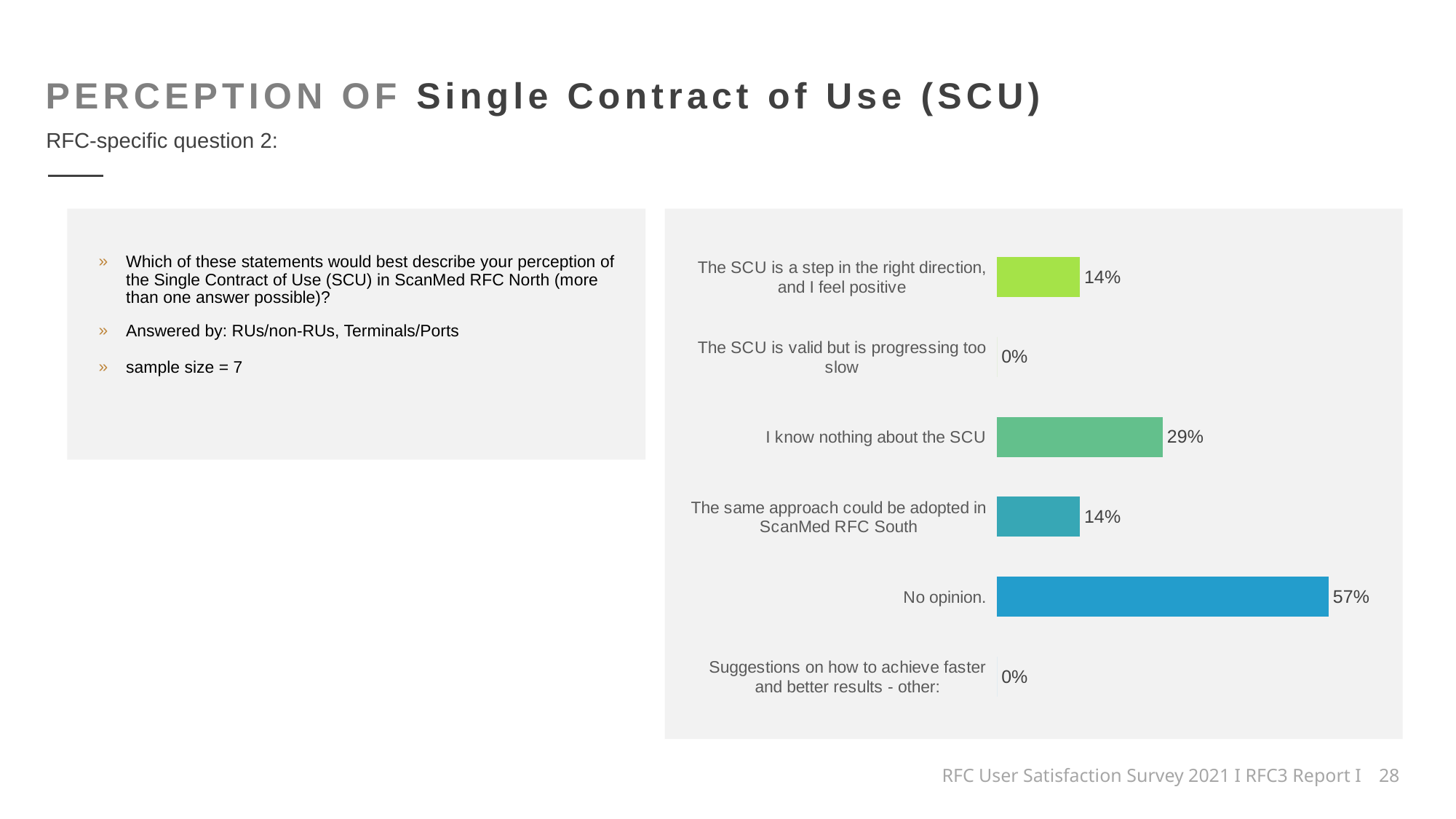
Which is larger: "I know nothing about the SCU" or "The same approach could be adopted in ScanMed RFC South"? I know nothing about the SCU What percentage chose "The SCU is a step in the right direction, and I feel positive"? 14% How many statements (categories) are shown in the chart? 6 What is the value for "I know nothing about the SCU"? 29% What is the sample size stated on the slide for this question? 7 What is the value for "The SCU is valid but is progressing too slow"? 0% What kind of chart is shown on the slide? Bar chart What is the difference between "No opinion." and "The same approach could be adopted in ScanMed RFC South"? 43% How many categories have a value of 0%? 2 Which statement has the highest percentage? No opinion. What is the difference between "No opinion." and "I know nothing about the SCU"? 28% What percentage of respondents said "No opinion."? 57%